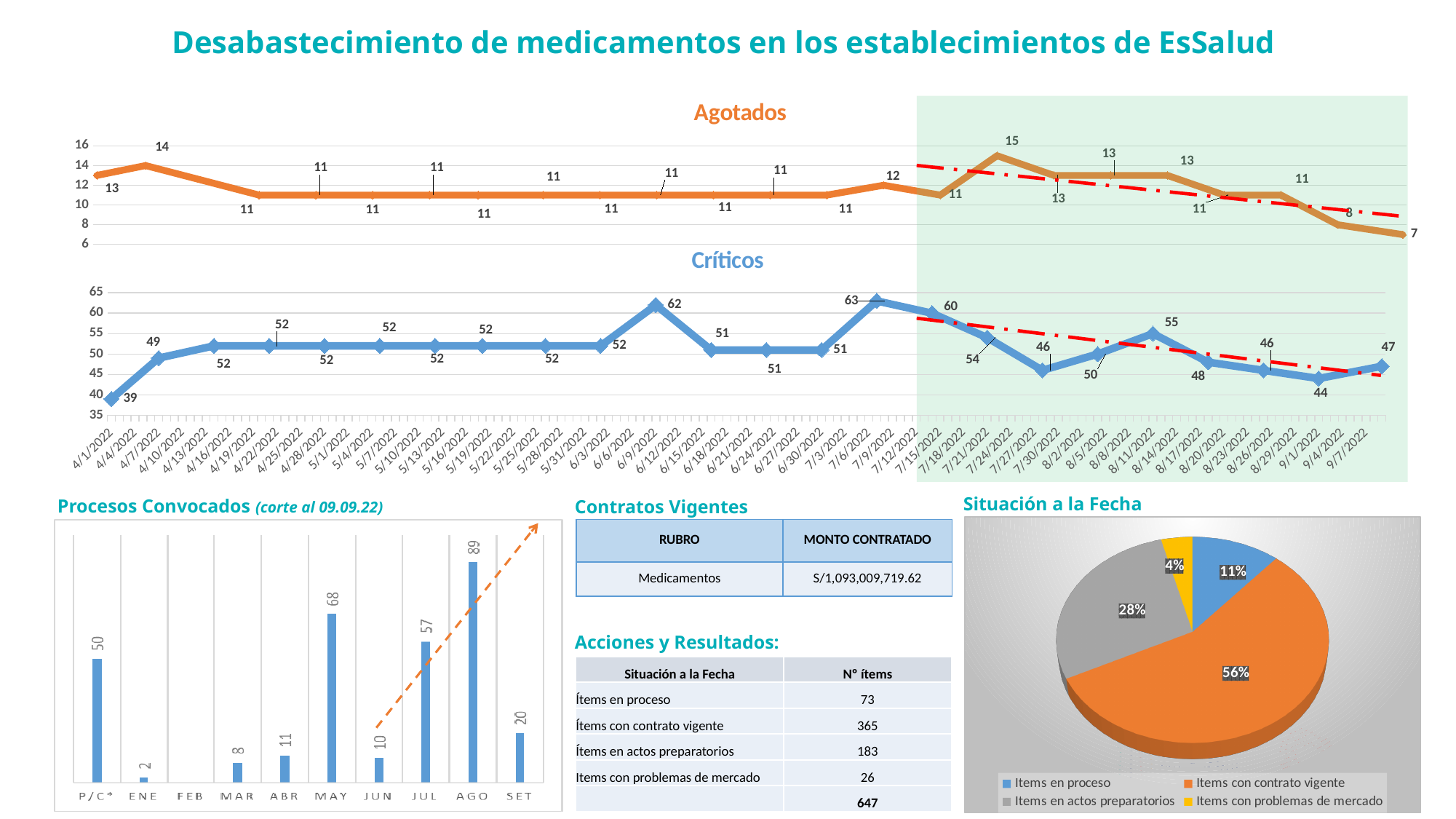
In the Críticos line chart, which date has the highest value? 7/7/2022 In the Situación a la Fecha pie chart, what share does 'Items con contrato vigente' have? 56% In the Situación a la Fecha pie chart, which category has the smallest slice? Items con problemas de mercado In the Críticos line chart, what is the value on 4/1/2022? 39 In the Agotados line chart, what is the value at the last date, 9/7/2022? 7 In the Procesos Convocados bar chart, what is the value for AGO? 89 In the Agotados line chart, which date has the highest value? 7/21/2022 In the Procesos Convocados bar chart, which month has the tallest bar? AGO In the Procesos Convocados bar chart, what is the difference between the values for AGO and MAY? 21 How many entries does the legend of the Situación a la Fecha pie chart list? 4